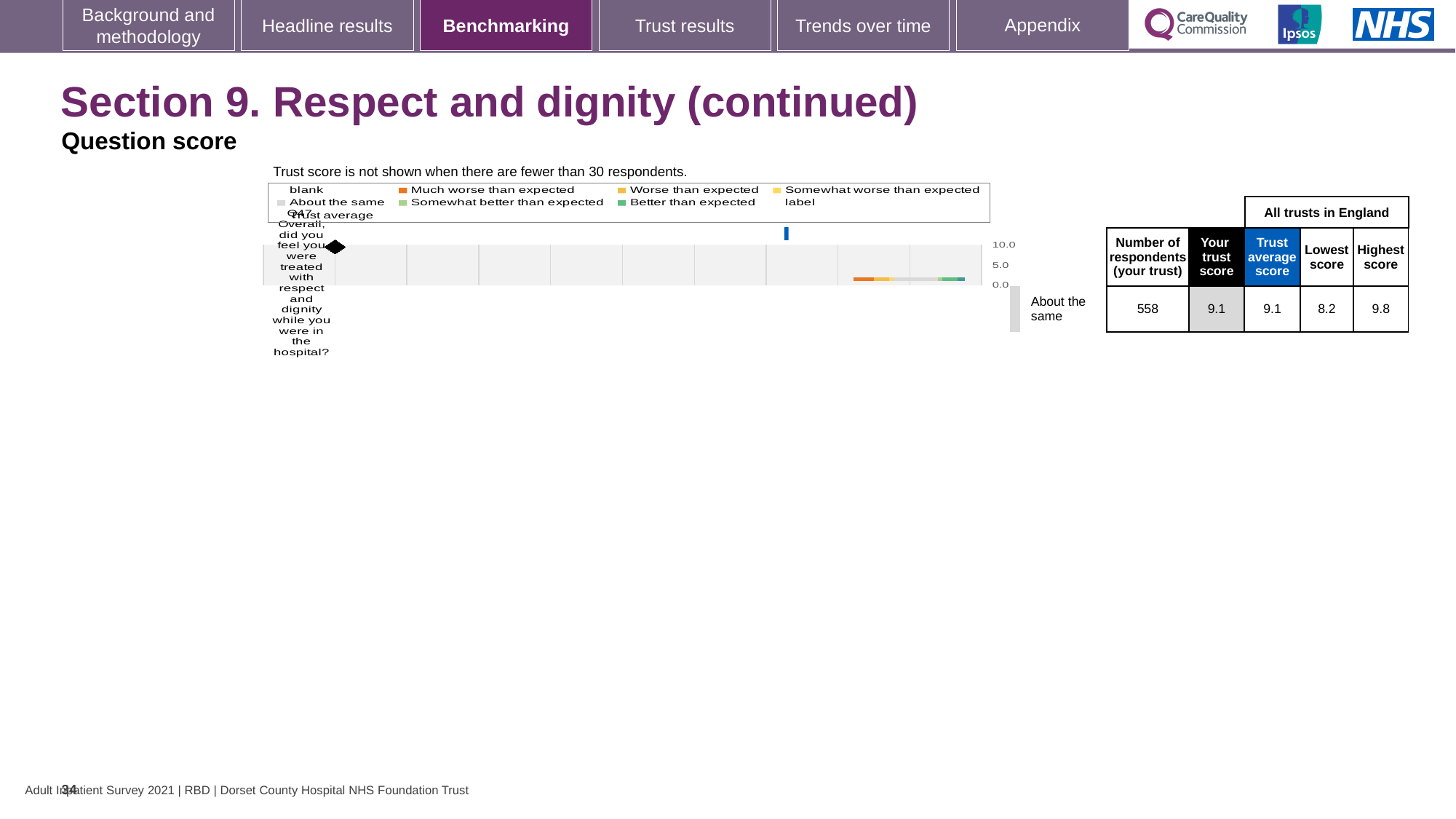
What is the trust average score for Q47 across all trusts in England? 9.1 What type of chart is used to show the Q47 benchmarking result? bar chart What is the lowest score for Q47 among all trusts in England? 8.2 What colour represents 'Much worse than expected' in the legend? orange What is the difference between the highest score and the lowest score for Q47? 1.6 How is your trust's Q47 result categorised relative to expectations? About the same How many questions are plotted in the benchmarking chart? 1 What is the highest score for Q47 among all trusts in England? 9.8 Which is larger for Q47: your trust score or the lowest score? your trust score Which question is plotted in the benchmarking chart? Q47 What is the number of respondents (your trust) for Q47? 558 What is your trust score for Q47? 9.1